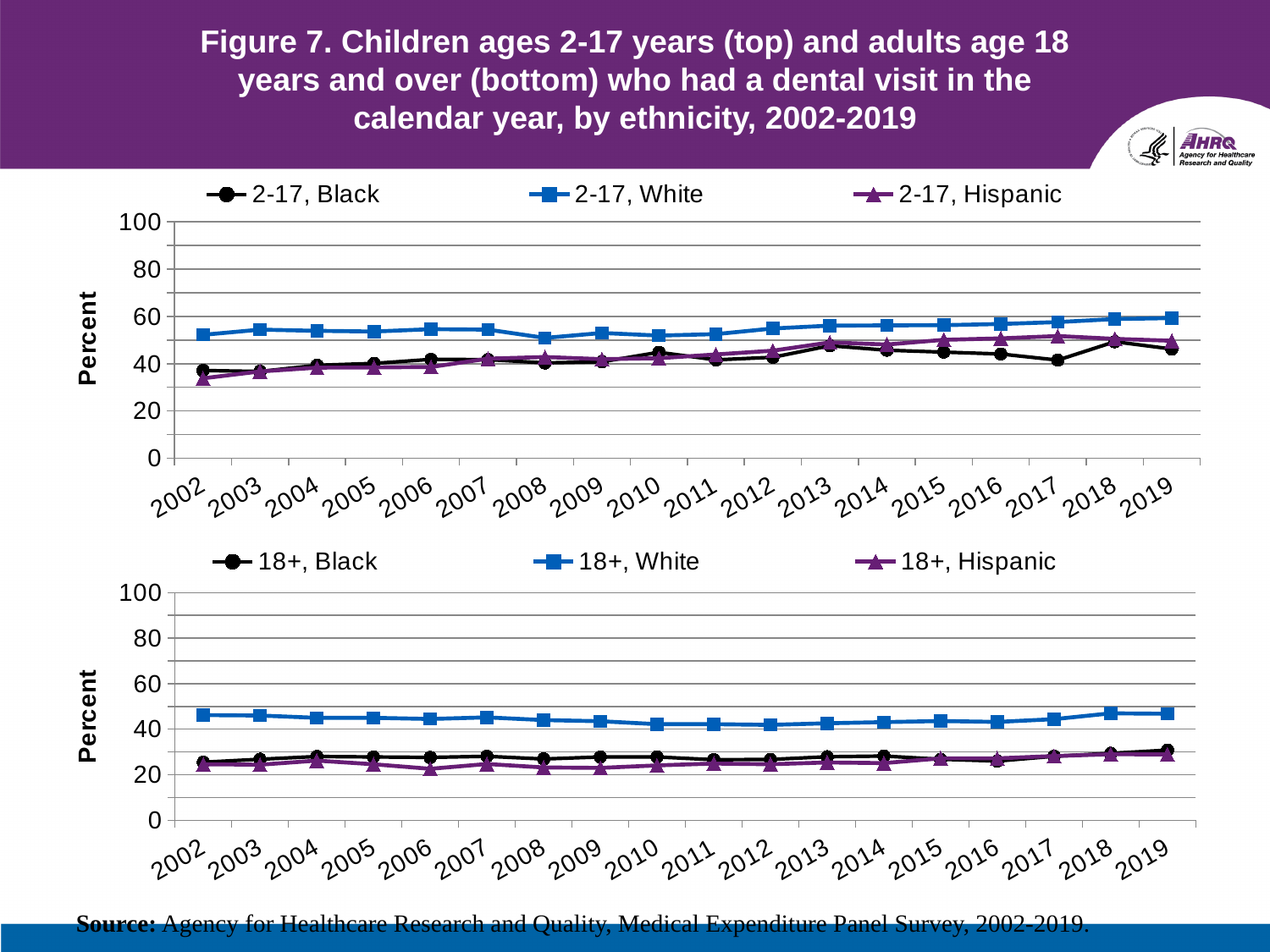
In the top chart, which is larger in 2019: the value for 2-17, White or 2-17, Black? 2-17, White What is the title of the y axis on the bottom chart? Percent What kind of chart is the top chart on the slide? Line chart In the bottom chart, is the value for 18+, Hispanic in 2006 greater or less than 40? less In the top chart, is the value for 2-17, White in 2019 greater or less than 40? greater In the top chart, which series has the highest value in 2010? 2-17, White How many series does the legend of the bottom chart list? 3 How many years are shown along the x axis of the top chart? 18 In the top chart, does the value for 2-17, Hispanic rise or fall from 2002 to 2019? rise In the bottom chart, is the value for 18+, White in 2002 greater or less than 40? greater In the bottom chart, which series has the lowest value in 2006? 18+, Hispanic